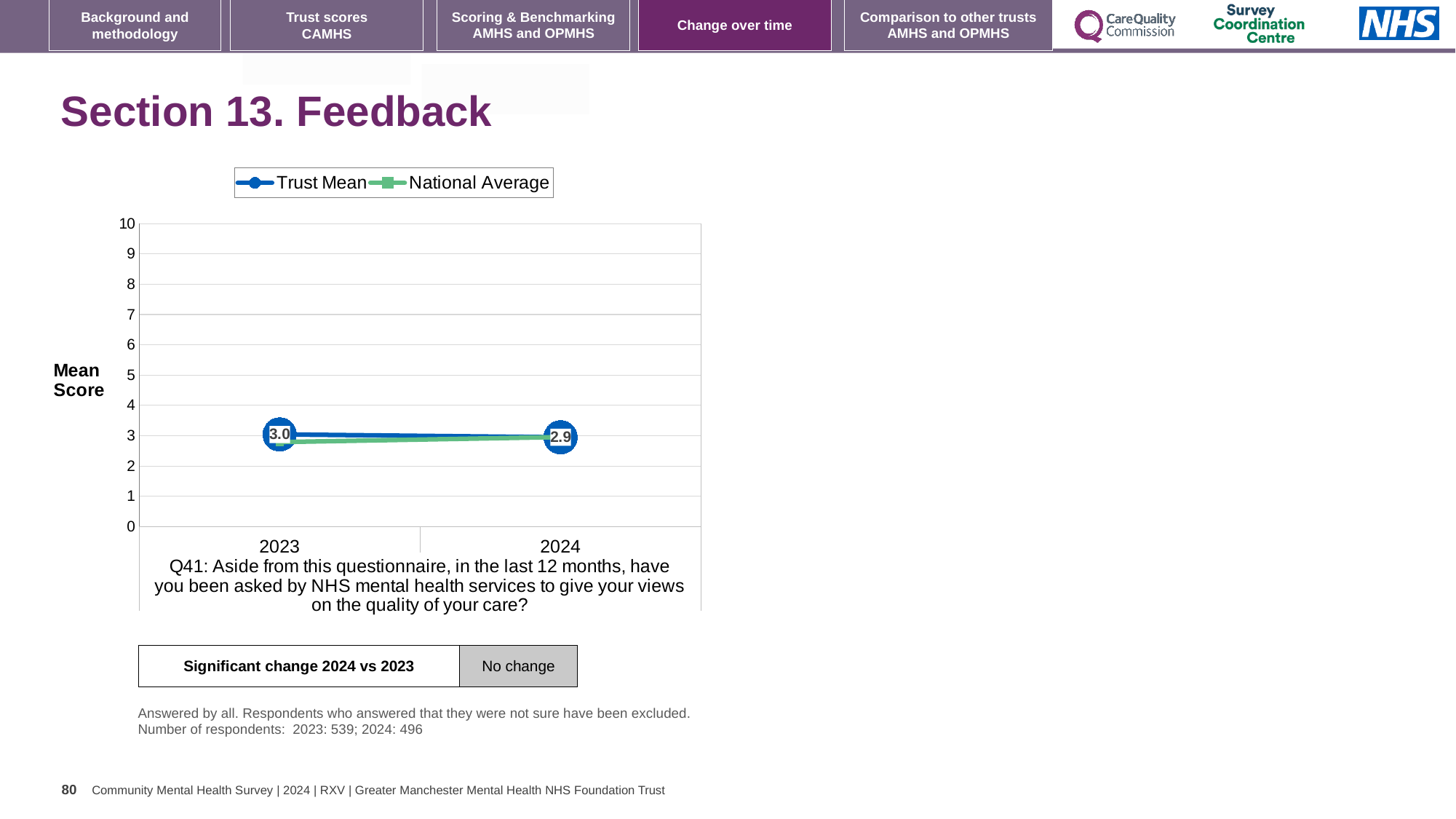
What is the label of the y axis? Mean Score What is the Trust Mean value for 2024? 2.9 Is the National Average value for 2024 greater or less than 2? greater Does the Trust Mean rise or fall from 2023 to 2024? fall What kind of chart is shown on the slide? line chart In which year is the Trust Mean higher, 2023 or 2024? 2023 By how much did the Trust Mean change from 2023 to 2024? 0.1 How many series does the legend list? 2 How many years are plotted on the x axis? 2 Which series is shown in green in the legend? National Average What is the Trust Mean value for 2023? 3.0 Is the National Average value for 2023 greater or less than 4? less